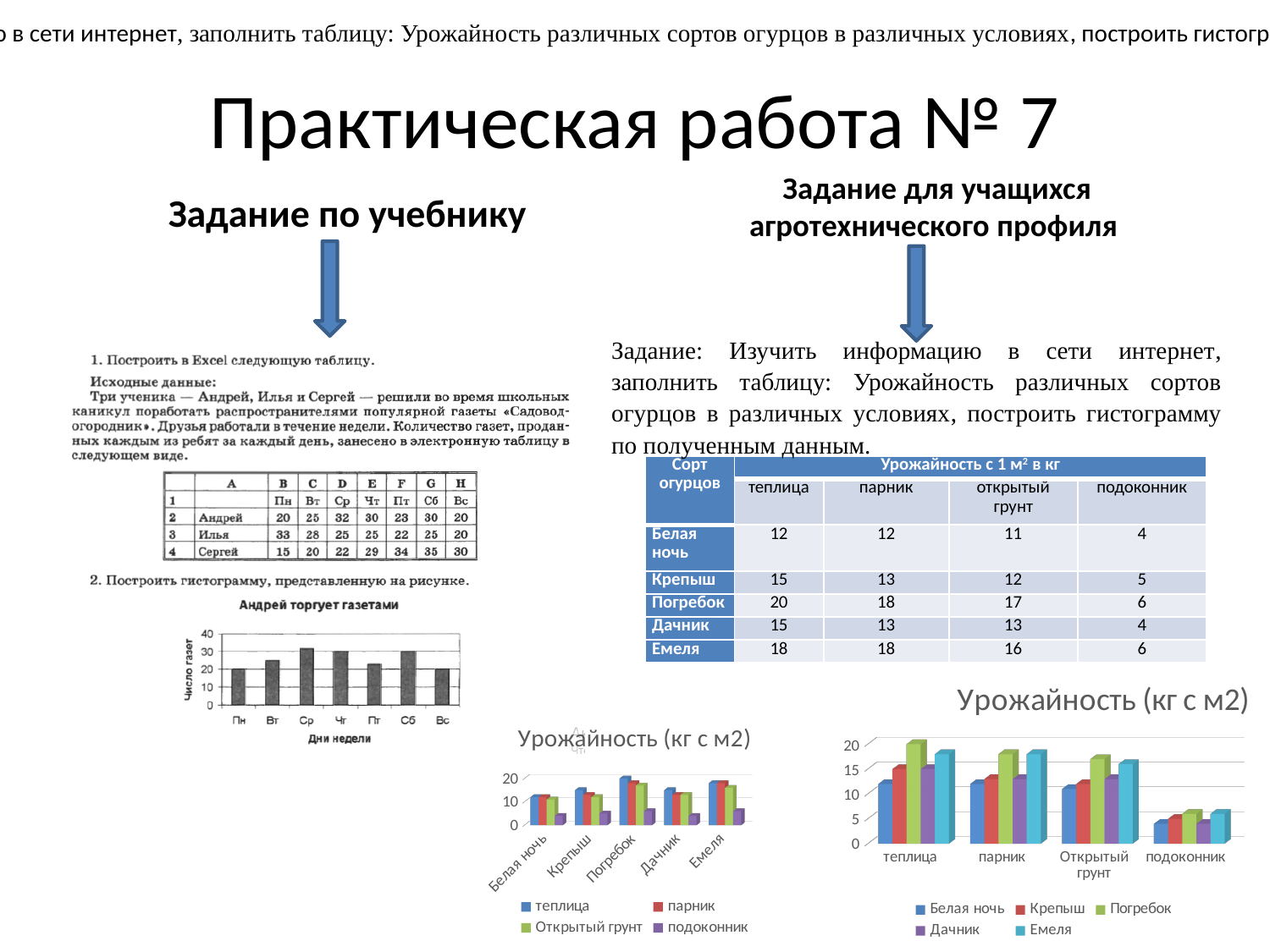
In the bottom-right chart "Урожайность (кг с м2)", which is larger in теплица: Погребок or Белая ночь? Погребок What kind of chart is the chart titled "Андрей торгует газетами" on the left of the slide? bar chart In the bottom-right chart "Урожайность (кг с м2)", how many categories are shown on the x axis? 4 In the chart "Андрей торгует газетами", what is the value for Пн? 20 In the chart "Андрей торгует газетами", which day has the tallest bar? Ср In the bottom-middle chart "Урожайность (кг с м2)", how many cucumber varieties are shown on the x axis? 5 In the bottom-right chart "Урожайность (кг с м2)", which category on the x axis has the lowest bars overall? подоконник In the chart "Андрей торгует газетами", is the value for Ср greater or less than 30? greater In the bottom-middle chart "Урожайность (кг с м2)" with cucumber varieties on the x axis, how many series does the legend list? 4 In the chart "Андрей торгует газетами", how many days of the week are shown on the x axis? 7 In the bottom-right chart "Урожайность (кг с м2)", is the value for Погребок in теплица greater or less than 15? greater In the bottom-right chart "Урожайность (кг с м2)" with growing conditions on the x axis, how many series does the legend list? 5